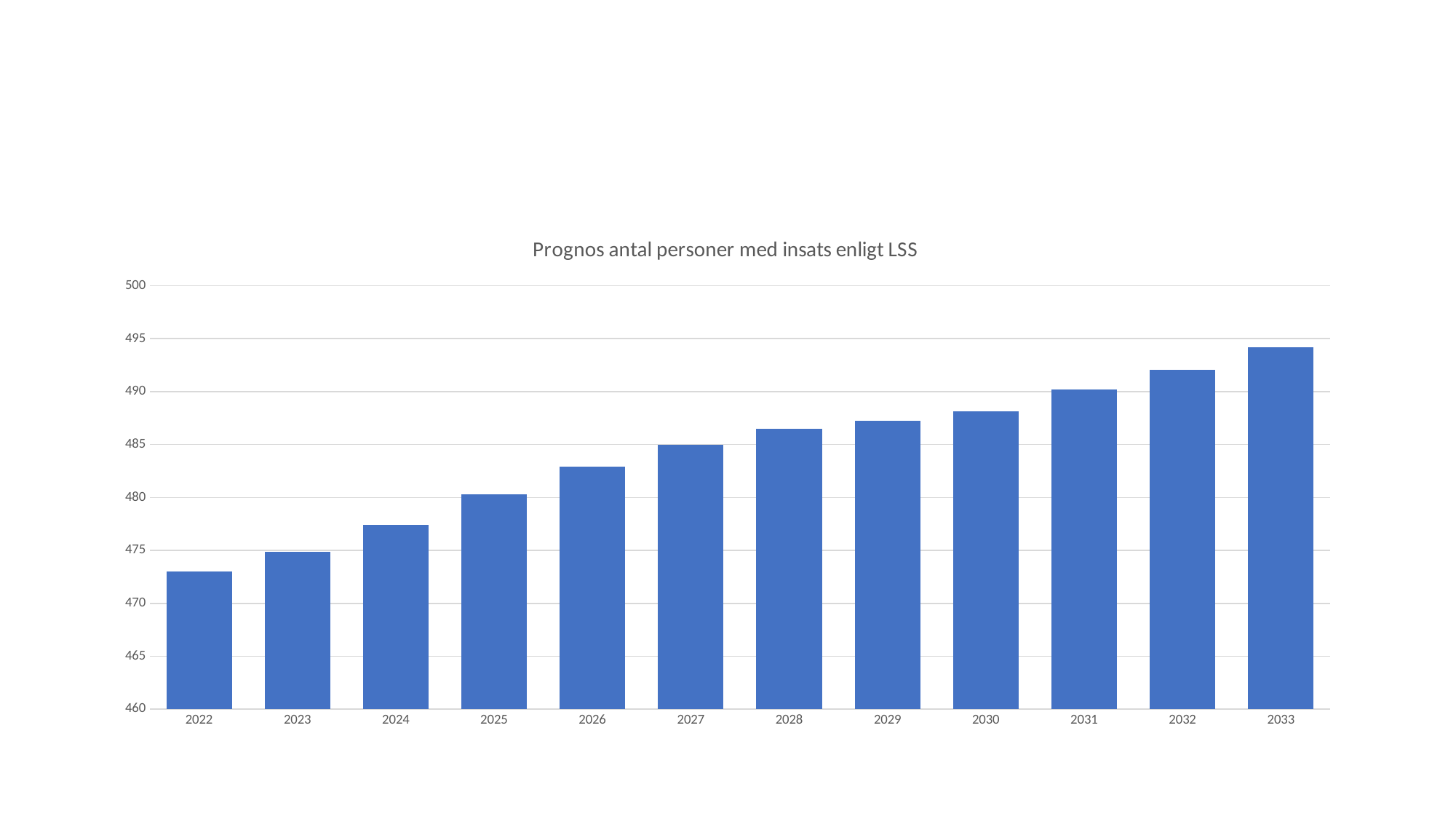
Which year has the lowest bar in the chart? 2022 What kind of chart is shown on the slide? bar chart What is the title of the chart? Prognos antal personer med insats enligt LSS Is the value for 2026 greater or less than 480? greater What colour are the bars in the chart? blue Is the value for 2030 greater or less than 490? less Is the value for 2022 greater or less than 475? less How many years are shown on the x axis of the chart? 12 Which is larger, the value for 2024 or the value for 2029? 2029 Do the values rise or fall from 2022 to 2033? rise Which year has the highest bar in the chart? 2033